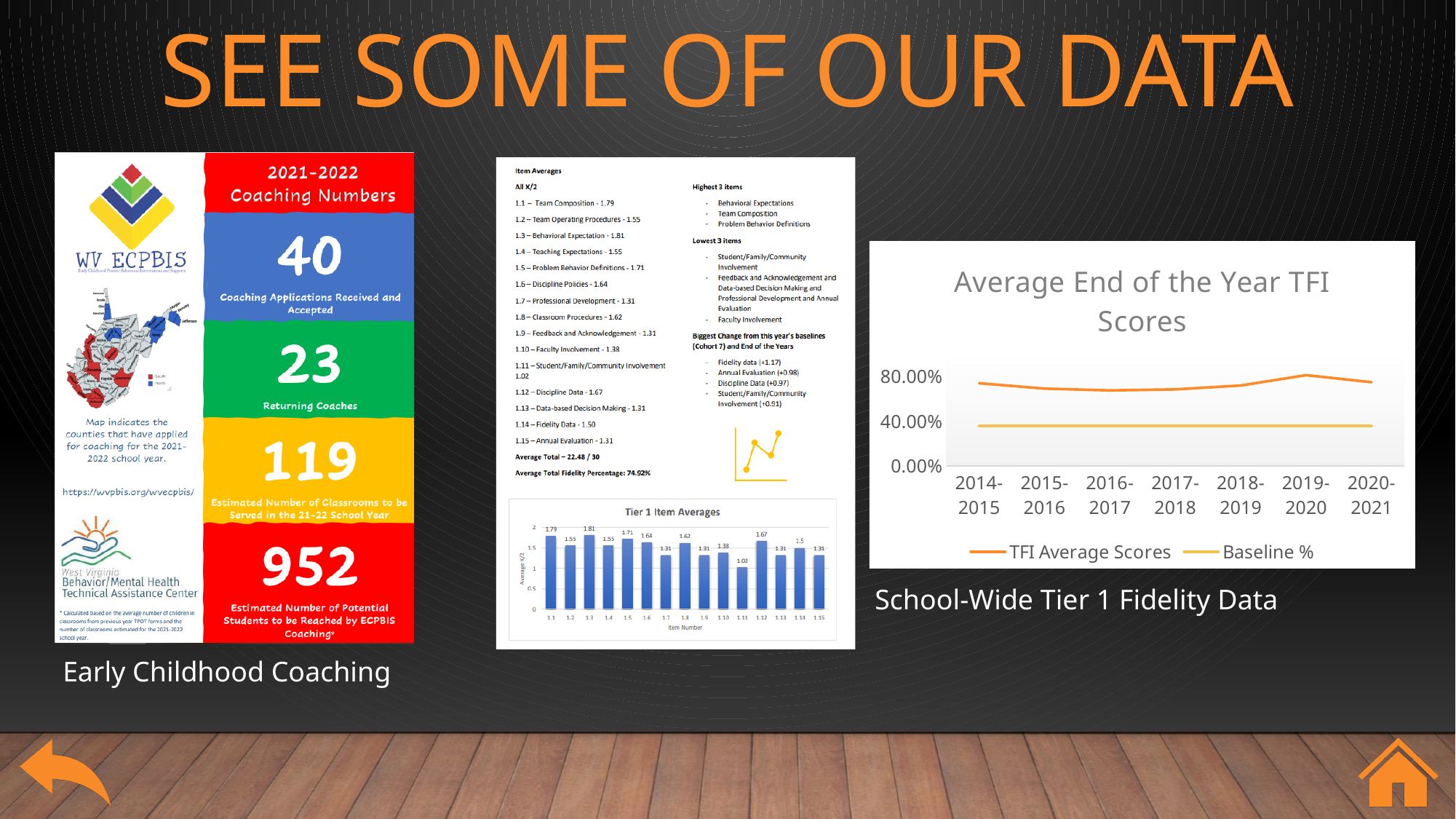
In the 'Tier 1 Item Averages' chart, what is the difference between the values for item 1.3 and item 1.11? 0.79 In the 'Tier 1 Item Averages' chart, what is the value for item 1.1? 1.79 In the 'Average End of the Year TFI Scores' chart, how many series does the legend list? 2 In the 'Average End of the Year TFI Scores' chart, how many school years are shown on the x axis? 7 In the 'Tier 1 Item Averages' chart, how many bars are plotted? 15 What kind of chart is the 'Tier 1 Item Averages' chart in the middle document? bar chart In the 'Average End of the Year TFI Scores' chart, is the TFI Average Score for 2014-2015 greater or less than 40.00%? greater In the 'Average End of the Year TFI Scores' chart, does the TFI Average Score rise or fall from 2018-2019 to 2019-2020? rise In the 'Tier 1 Item Averages' chart, which item number has the lowest average? 1.11 In the 'Average End of the Year TFI Scores' chart, is the Baseline % value for 2016-2017 greater or less than 40.00%? less In the 'Tier 1 Item Averages' chart, which item number has the highest average? 1.3 In the 'Average End of the Year TFI Scores' chart, which school year has the highest TFI Average Score? 2019-2020